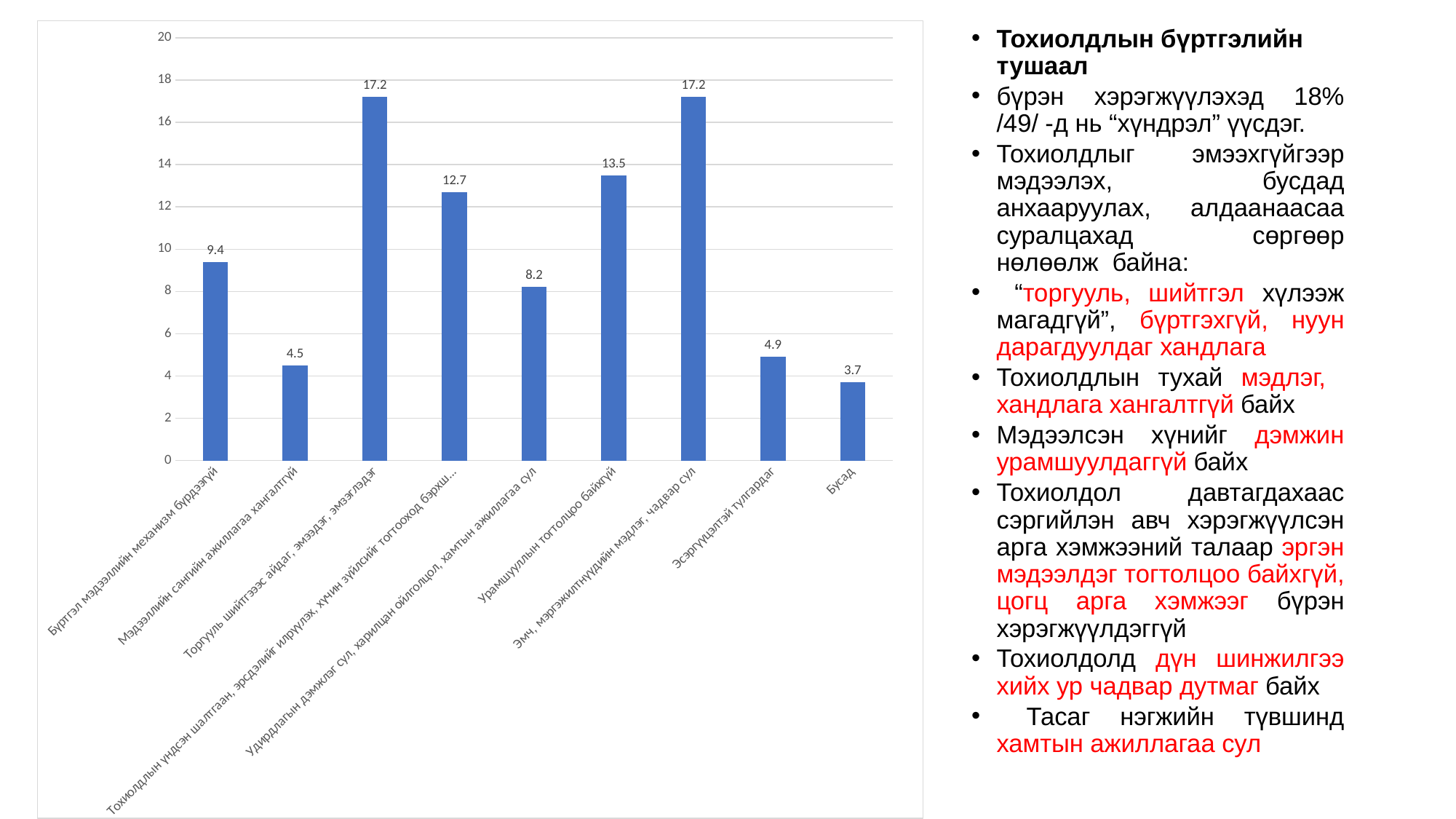
What is the difference between the values for "Урамшууллын тогтолцоо байхгүй" and "Эсэргүүцэлтэй тулгардаг"? 8.6 What is the value for "Урамшууллын тогтолцоо байхгүй"? 13.5 What is the value for "Бүртгэл мэдээллийн механизм бүрдээгүй"? 9.4 What is the value for "Эсэргүүцэлтэй тулгардаг"? 4.9 What kind of chart is shown on the slide? bar chart What is the value for "Мэдээллийн сангийн ажиллагаа хангалтгүй"? 4.5 What is the value for "Эмч, мэргэжилтнүүдийн мэдлэг, чадвар сул"? 17.2 Is the value for "Урамшууллын тогтолцоо байхгүй" greater or less than 10? greater What is the value for "Бусад"? 3.7 How many categories are shown in the chart? 9 Which is larger: the value for "Бүртгэл мэдээллийн механизм бүрдээгүй" or the value for "Мэдээллийн сангийн ажиллагаа хангалтгүй"? Бүртгэл мэдээллийн механизм бүрдээгүй Which category has the lowest value? Бусад